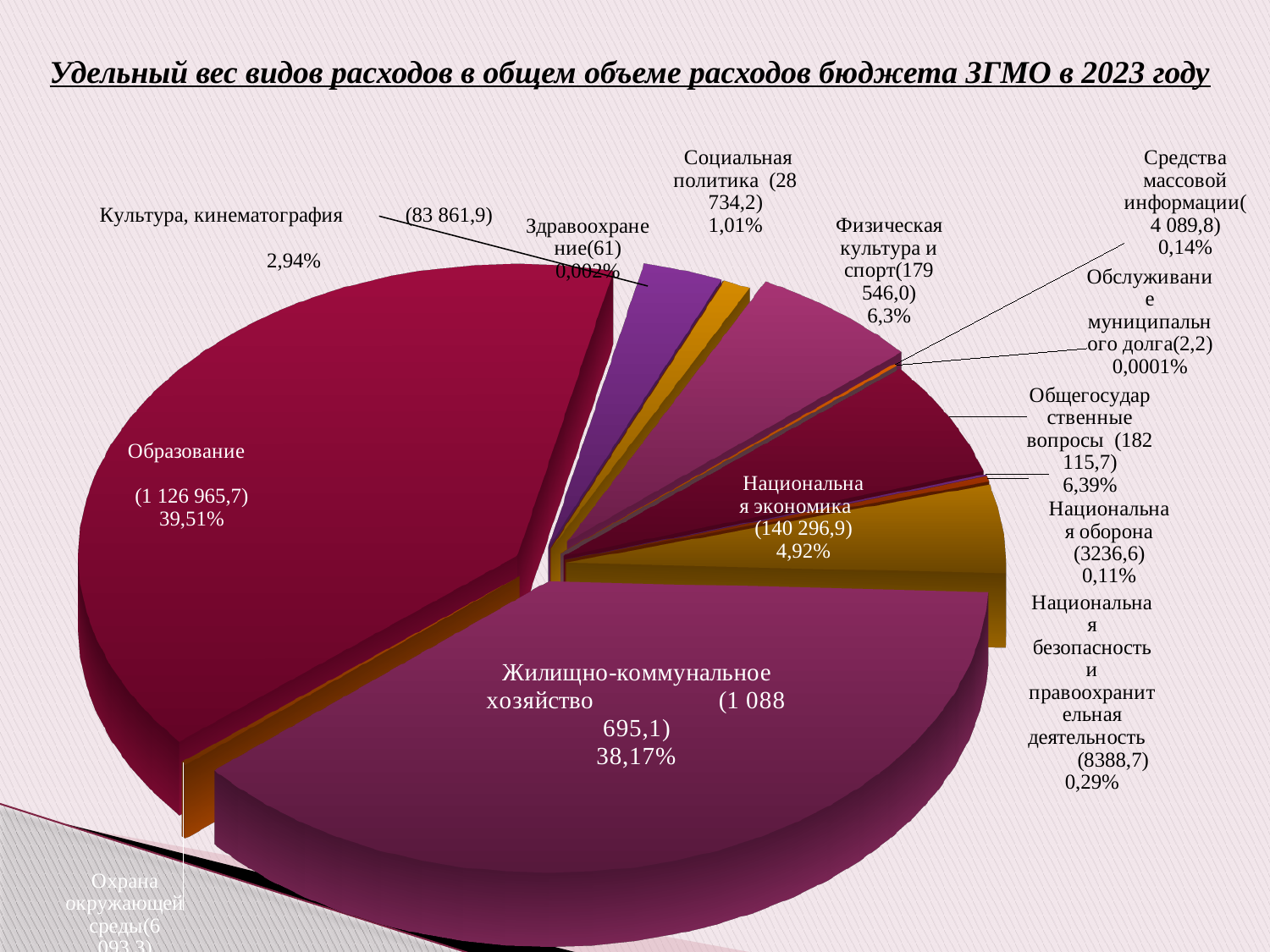
What share of the budget does Образование account for? 39,51% What is the amount shown for Национальная экономика? 140 296,9 Which expenditure type has the smallest share of the budget? Обслуживание муниципального долга Which expenditure type has the largest share of the 2023 ZGMO budget? Образование By how many percentage points does the share of Образование exceed that of Жилищно-коммунальное хозяйство? 1,34 Which has a larger share: Общегосударственные вопросы or Национальная экономика? Общегосударственные вопросы What percentage is shown for Культура, кинематография? 2,94% What share of the budget does Жилищно-коммунальное хозяйство account for? 38,17% What is the amount shown for Социальная политика? 28 734,2 What is the amount shown for Общегосударственные вопросы? 182 115,7 What kind of chart is shown on the slide? pie chart